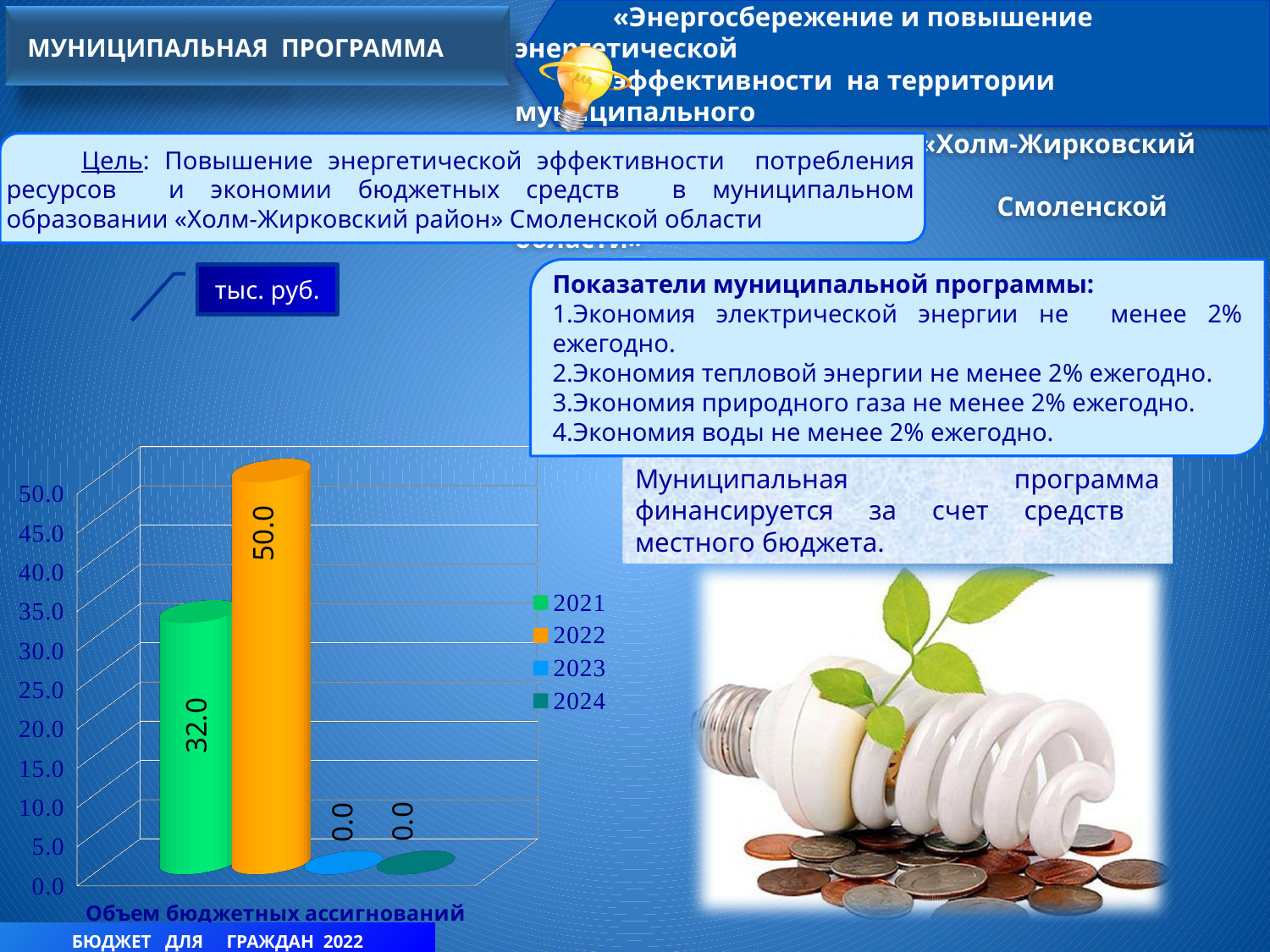
Is the value for 2021 greater or less than 30.0? greater What is the value for 2023 in the chart? 0.0 Which year has the highest value in the chart? 2022 What is the value for 2024 in the chart? 0.0 What kind of chart is shown on the slide? bar chart How many series does the chart legend list? 4 What is the category label shown below the chart? Объем бюджетных ассигнований What is the value for 2021 in the chart? 32.0 What is the difference between the values for 2022 and 2021? 18.0 What is the value for 2022 in the chart? 50.0 What unit is indicated for the chart values? тыс. руб. Which is larger, the value for 2021 or the value for 2022? 2022